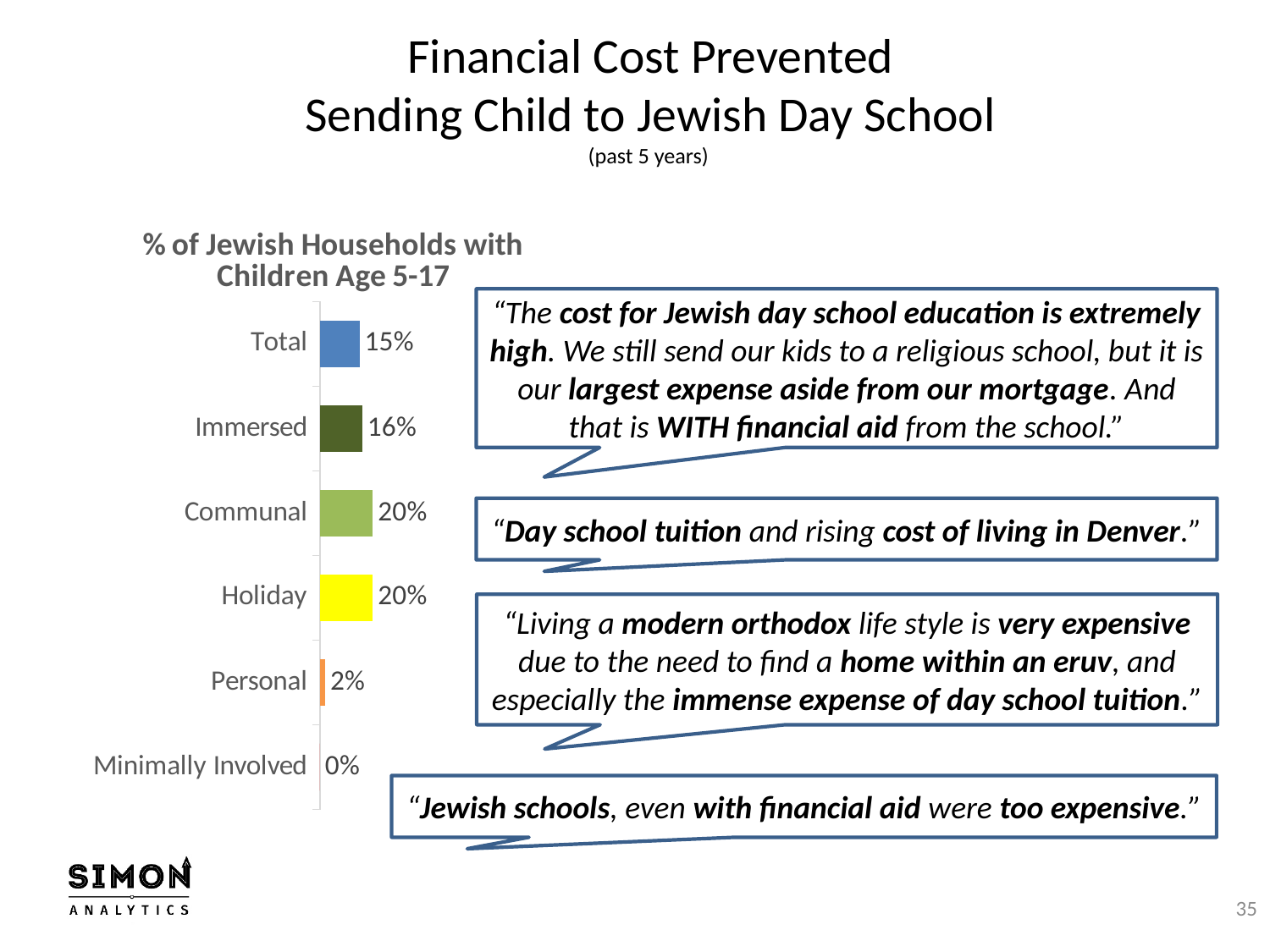
What is the value for Immersed? 16% What kind of chart is shown on the slide? Bar chart What is the title of the chart? % of Jewish Households with Children Age 5-17 What is the difference between the values for Immersed and Total? 1% What is the value for Minimally Involved? 0% What is the value for Total? 15% Which is larger, the value for Personal or the value for Total? Total What is the value for Personal? 2% Which is larger, the value for Holiday or the value for Immersed? Holiday How many categories are shown in the chart? 6 What is the difference between the values for Communal and Personal? 18% Which category has the lowest value? Minimally Involved